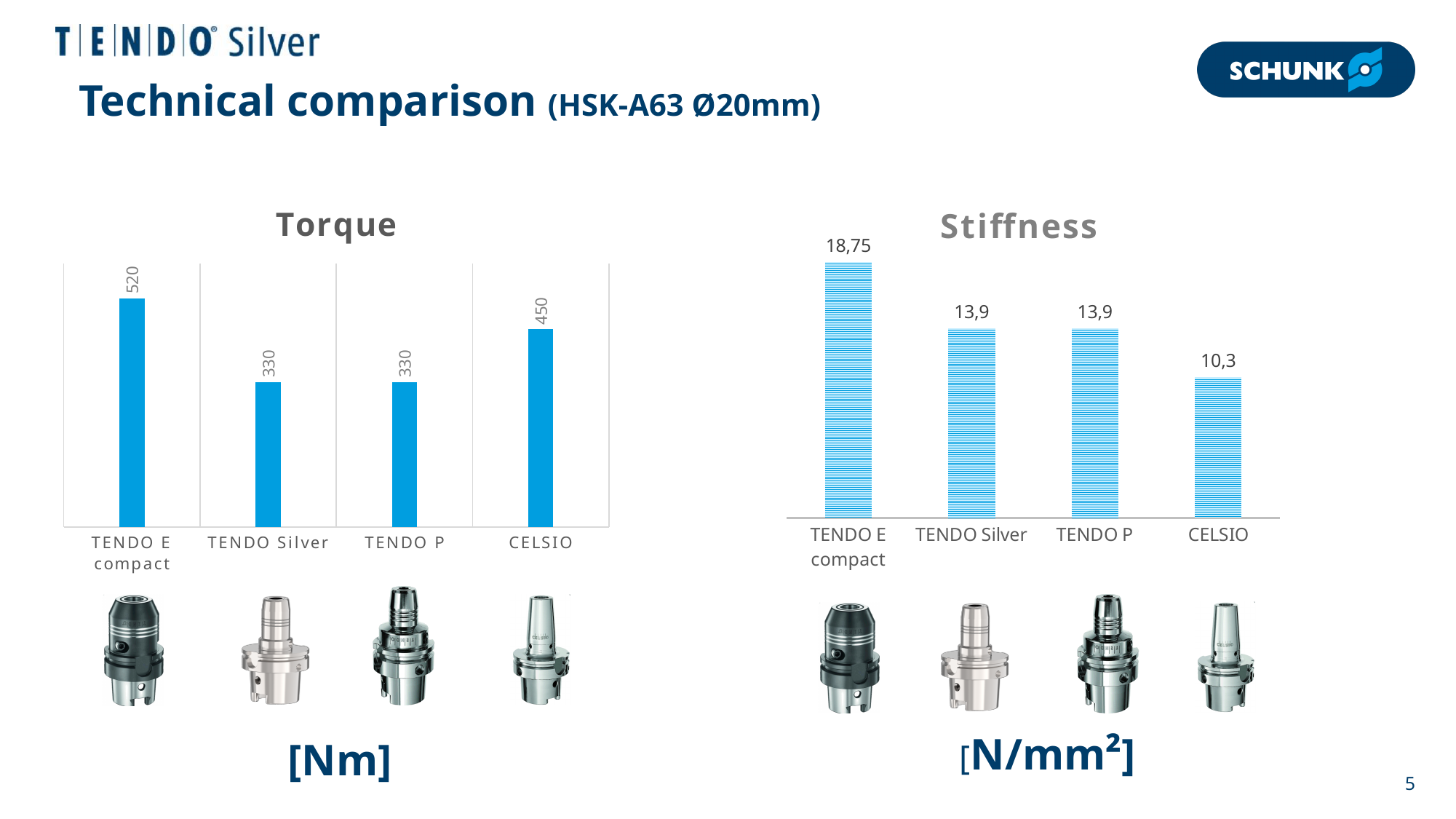
In the Torque chart, which category has the highest value? TENDO E compact What kind of chart is the Stiffness chart? bar chart In the Torque chart, what is the value for TENDO E compact? 520 In the Stiffness chart, what is the value for CELSIO? 10,3 In the Torque chart, how many categories are shown? 4 In the Stiffness chart, what is the value for TENDO E compact? 18,75 In the Stiffness chart, which category has the lowest value? CELSIO In the Stiffness chart, which is larger, TENDO Silver or CELSIO? TENDO Silver In the Torque chart, what is the value for CELSIO? 450 In the Torque chart, what is the difference between TENDO E compact and TENDO Silver? 190 In the Stiffness chart, what is the difference between TENDO E compact and TENDO P? 4,85 What unit is shown below the Torque chart? [Nm]